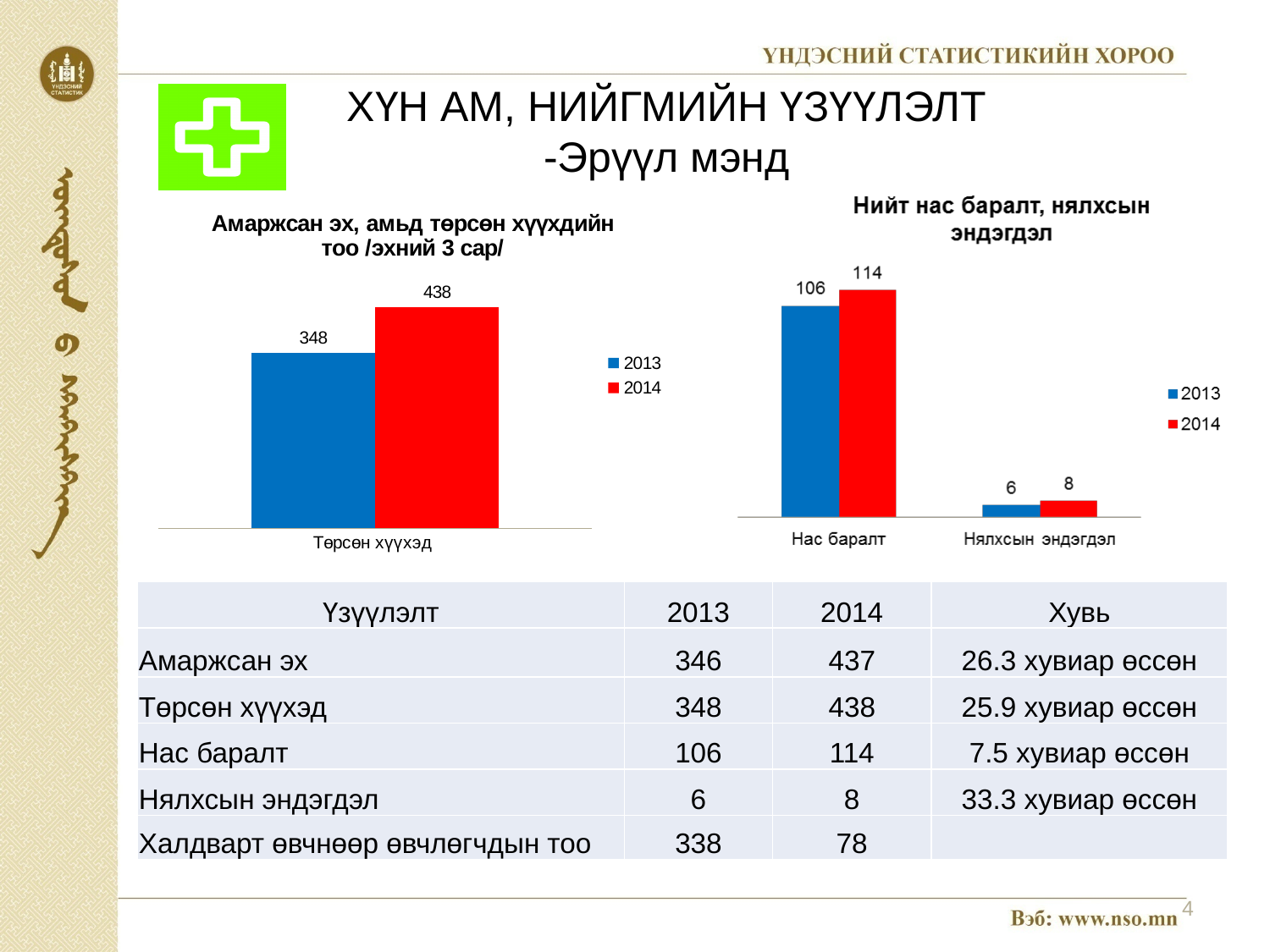
In the left chart (Амаржсан эх, амьд төрсөн хүүхдийн тоо /эхний 3 сар/), what is the value for 2014 for Төрсөн хүүхэд? 438 In the left chart (Амаржсан эх, амьд төрсөн хүүхдийн тоо /эхний 3 сар/), what is the value for 2013 for Төрсөн хүүхэд? 348 In the left chart (Амаржсан эх, амьд төрсөн хүүхдийн тоо /эхний 3 сар/), what is the difference between the 2014 and 2013 values? 90 In the right chart (Нийт нас баралт, нялхсын эндэгдэл), which is larger: the 2013 value for Нялхсын эндэгдэл or the 2014 value for Нялхсын эндэгдэл? 2014 What kind of chart is the right chart (Нийт нас баралт, нялхсын эндэгдэл)? Bar chart In the right chart (Нийт нас баралт, нялхсын эндэгдэл), what is the difference between the 2014 and 2013 values for Нас баралт? 8 In the right chart (Нийт нас баралт, нялхсын эндэгдэл), which category has the highest value in 2014? Нас баралт In the right chart (Нийт нас баралт, нялхсын эндэгдэл), how many categories are shown on the x axis? 2 In the right chart (Нийт нас баралт, нялхсын эндэгдэл), what is the 2014 value for Нялхсын эндэгдэл? 8 In the right chart (Нийт нас баралт, нялхсын эндэгдэл), what colour represents the 2014 series? Red In the left chart (Амаржсан эх, амьд төрсөн хүүхдийн тоо /эхний 3 сар/), how many series does the legend list? 2 In the right chart (Нийт нас баралт, нялхсын эндэгдэл), what is the 2013 value for Нас баралт? 106